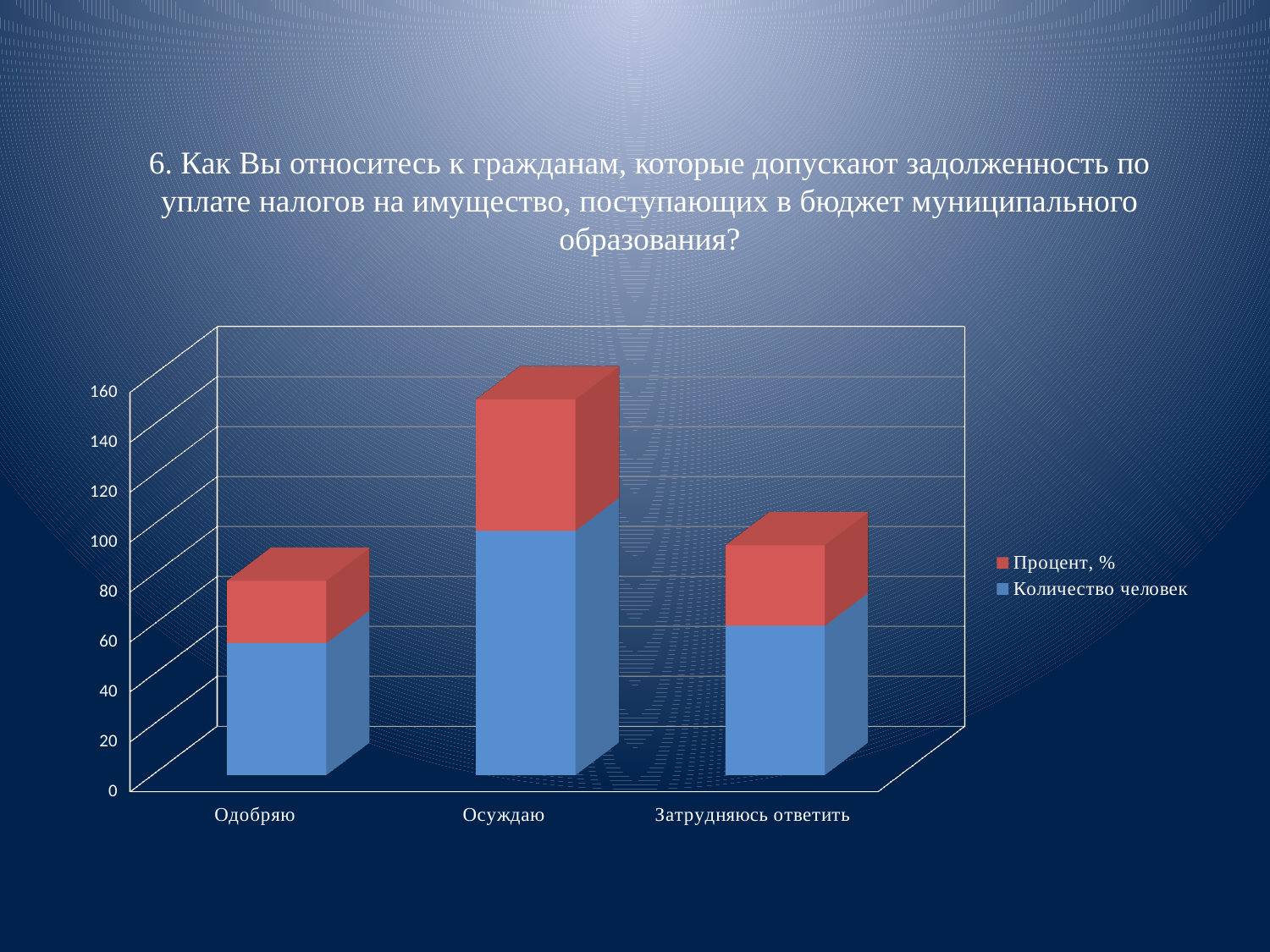
Which category has the shortest stacked bar? Одобряю Is the total stacked value for Осуждаю greater or less than 120? greater Is the total stacked value for Затрудняюсь ответить greater or less than 120? less Is the Количество человек value for Одобряю greater or less than 80? less What kind of chart is shown on the slide? bar chart Which category has the tallest stacked bar? Осуждаю Which series is shown in blue in the chart? Количество человек How many categories are shown on the x axis of the chart? 3 Which series is shown in red in the chart? Процент, % How many series does the chart legend list? 2